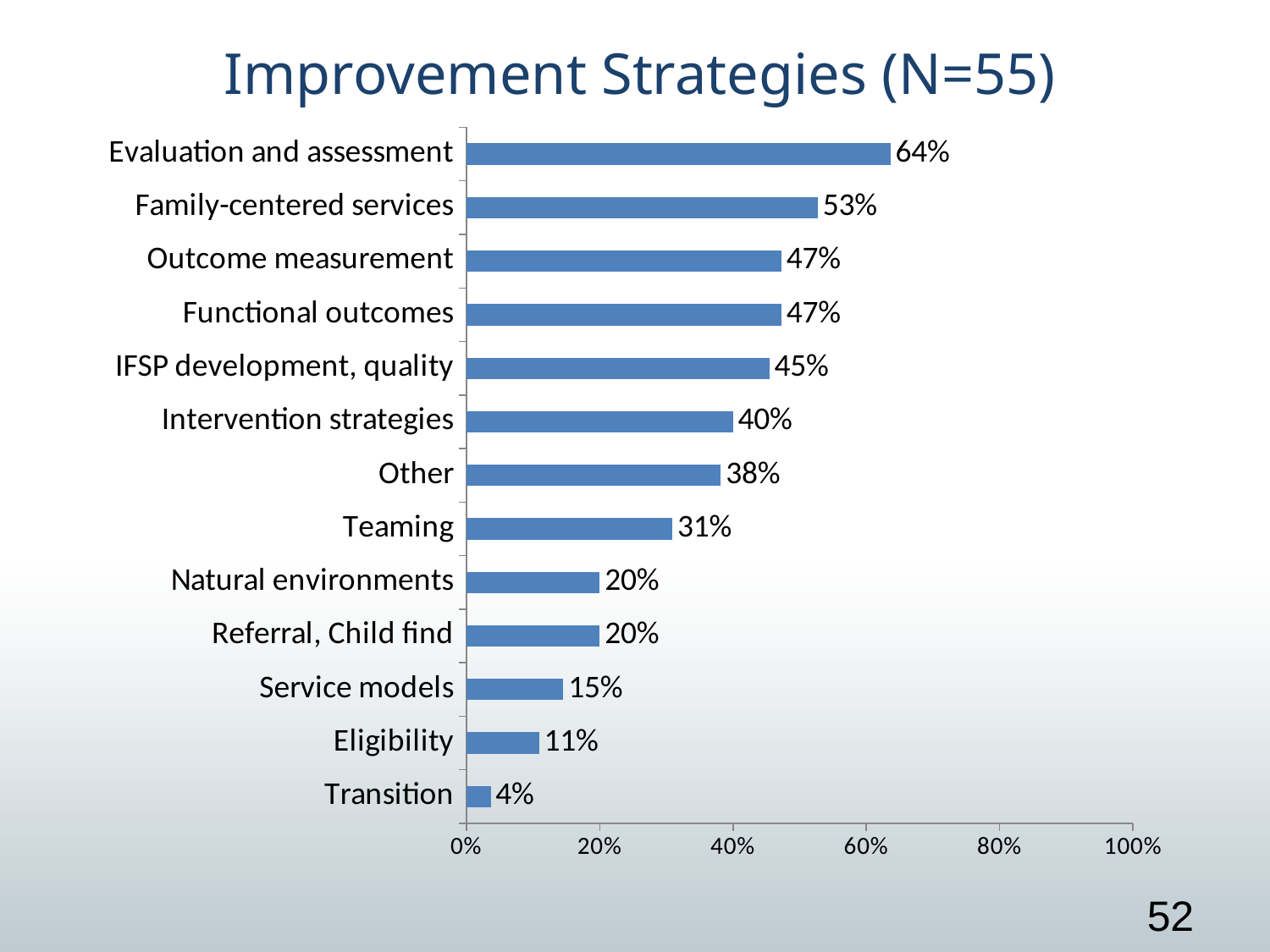
What is the difference between Family-centered services and Intervention strategies? 13% What kind of chart is shown on the slide? Bar chart What is the difference between Evaluation and assessment and Transition? 60% What percentage is shown for Evaluation and assessment? 64% What is the title of the chart? Improvement Strategies (N=55) What percentage is shown for Service models? 15% What percentage is shown for Teaming? 31% Which category has the lowest value? Transition Which category has the highest value? Evaluation and assessment How many categories are shown in the chart? 13 Which is larger, Other or Teaming? Other Which is larger, Eligibility or Natural environments? Natural environments